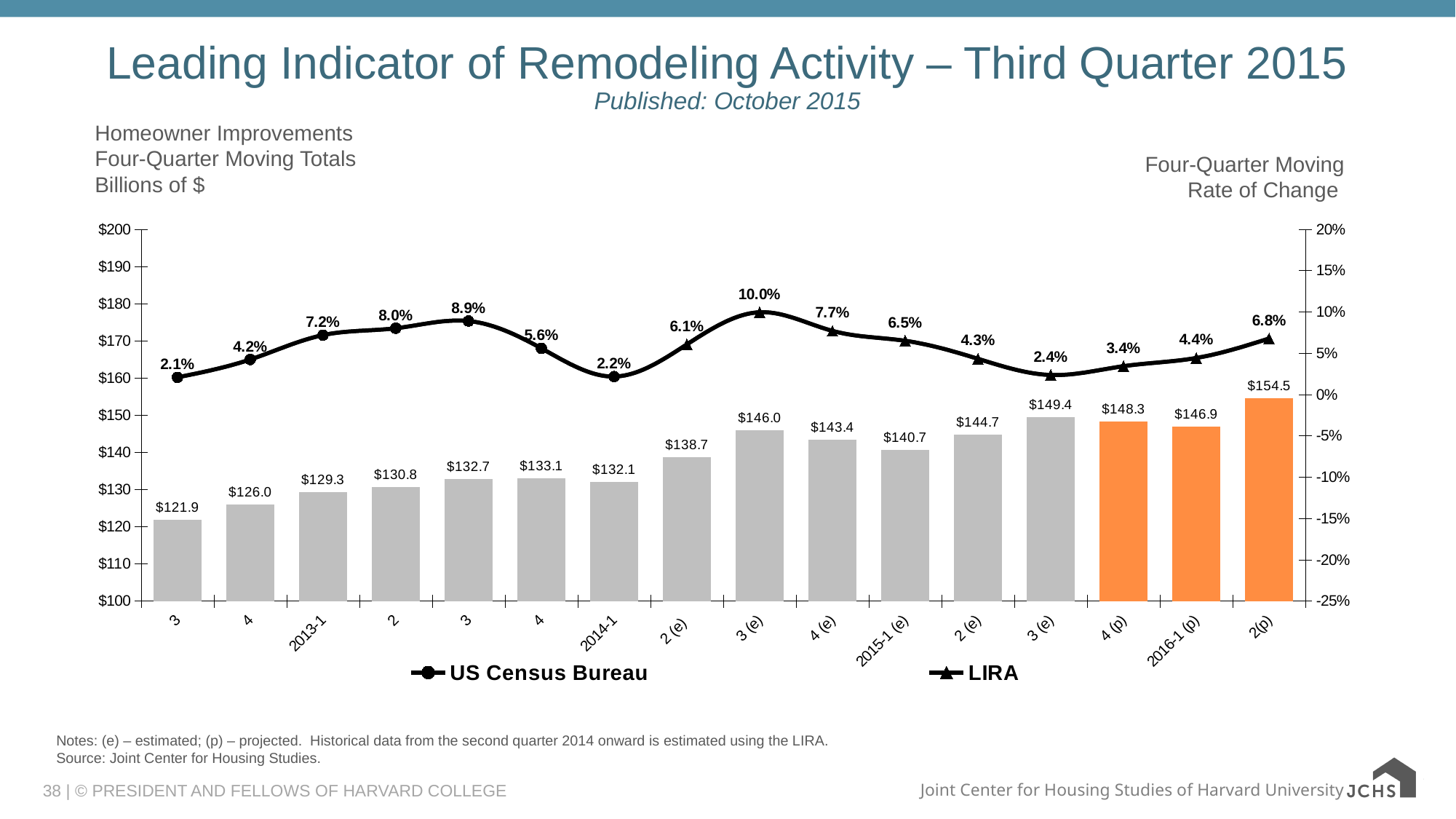
Which period has the highest four-quarter moving total? 2(p) How many bars are plotted in the chart? 16 What kind of chart is shown on the slide? Combination bar and line chart Which has the larger four-quarter moving total, 2015-1 (e) or 2014-1? 2015-1 (e) What is the four-quarter moving total for 2016-1 (p)? $146.9 What is the difference between the four-quarter moving totals for 2(p) and 3 (e) in 2015? $5.1 How many series does the legend list? 2 What colour are the bars for the projected (p) periods? Orange Does the rate of change line rise or fall from 3 (e) in 2014 to 3 (e) in 2015? Fall What is the four-quarter moving total for 2013-1? $129.3 What is the lowest four-quarter moving rate of change shown on the line? 2.1%